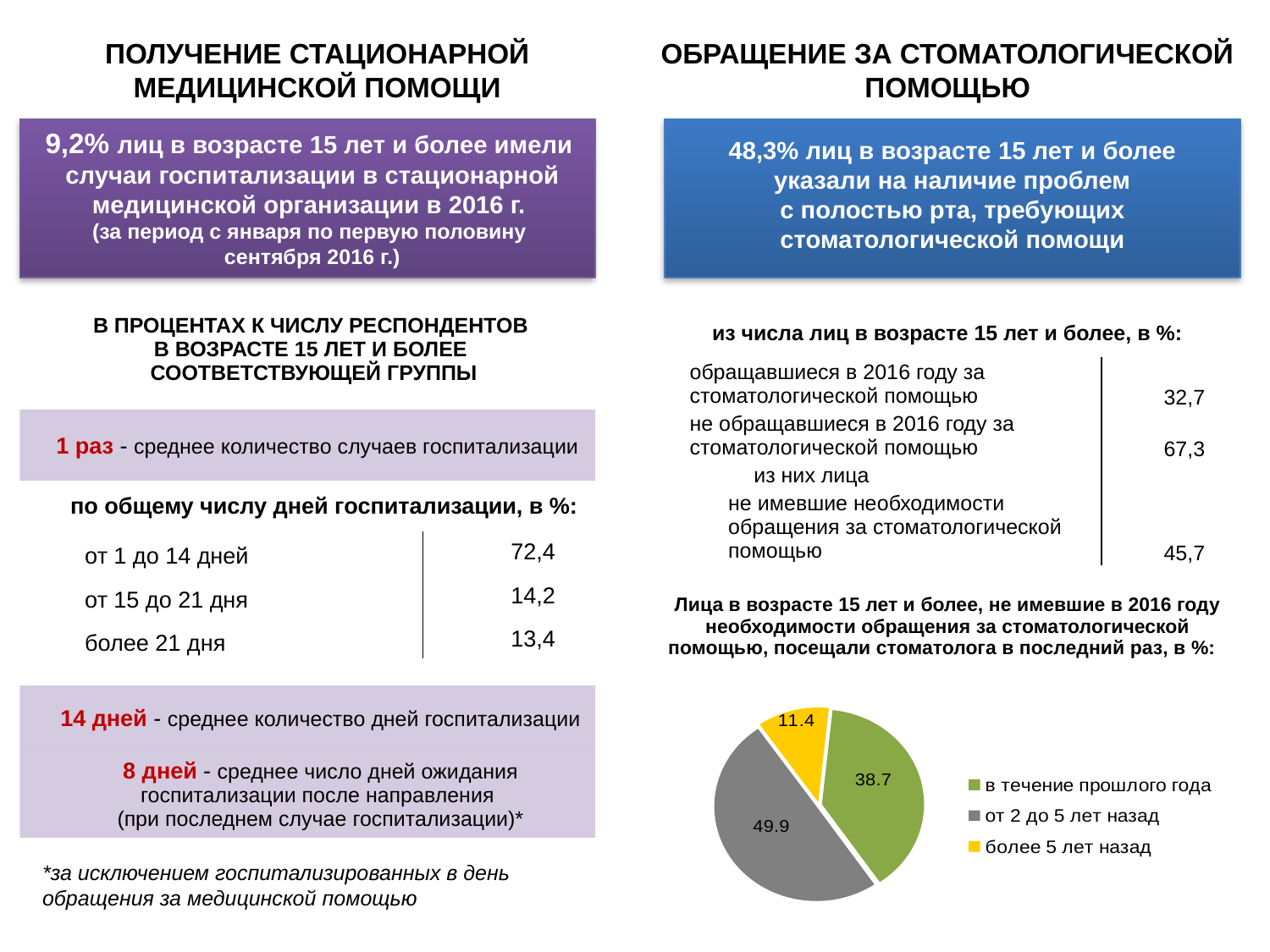
Какое значение на круговой диаграмме соответствует категории «в течение прошлого года»? 38.7 Какое значение на круговой диаграмме соответствует категории «от 2 до 5 лет назад»? 49.9 На сколько значение «в течение прошлого года» больше значения «более 5 лет назад» на круговой диаграмме? 27.3 Сколько записей содержит легенда круговой диаграммы? 3 Что больше на круговой диаграмме: «в течение прошлого года» или «более 5 лет назад»? в течение прошлого года Какое значение на круговой диаграмме соответствует категории «более 5 лет назад»? 11.4 Каким цветом на круговой диаграмме обозначена категория «более 5 лет назад»? жёлтым Какой тип диаграммы показан на слайде? круговая диаграмма Какая категория на круговой диаграмме имеет наибольшую долю? от 2 до 5 лет назад Какая категория на круговой диаграмме имеет наименьшую долю? более 5 лет назад На сколько значение «от 2 до 5 лет назад» больше значения «в течение прошлого года» на круговой диаграмме? 11.2 Сколько категорий показано на круговой диаграмме? 3